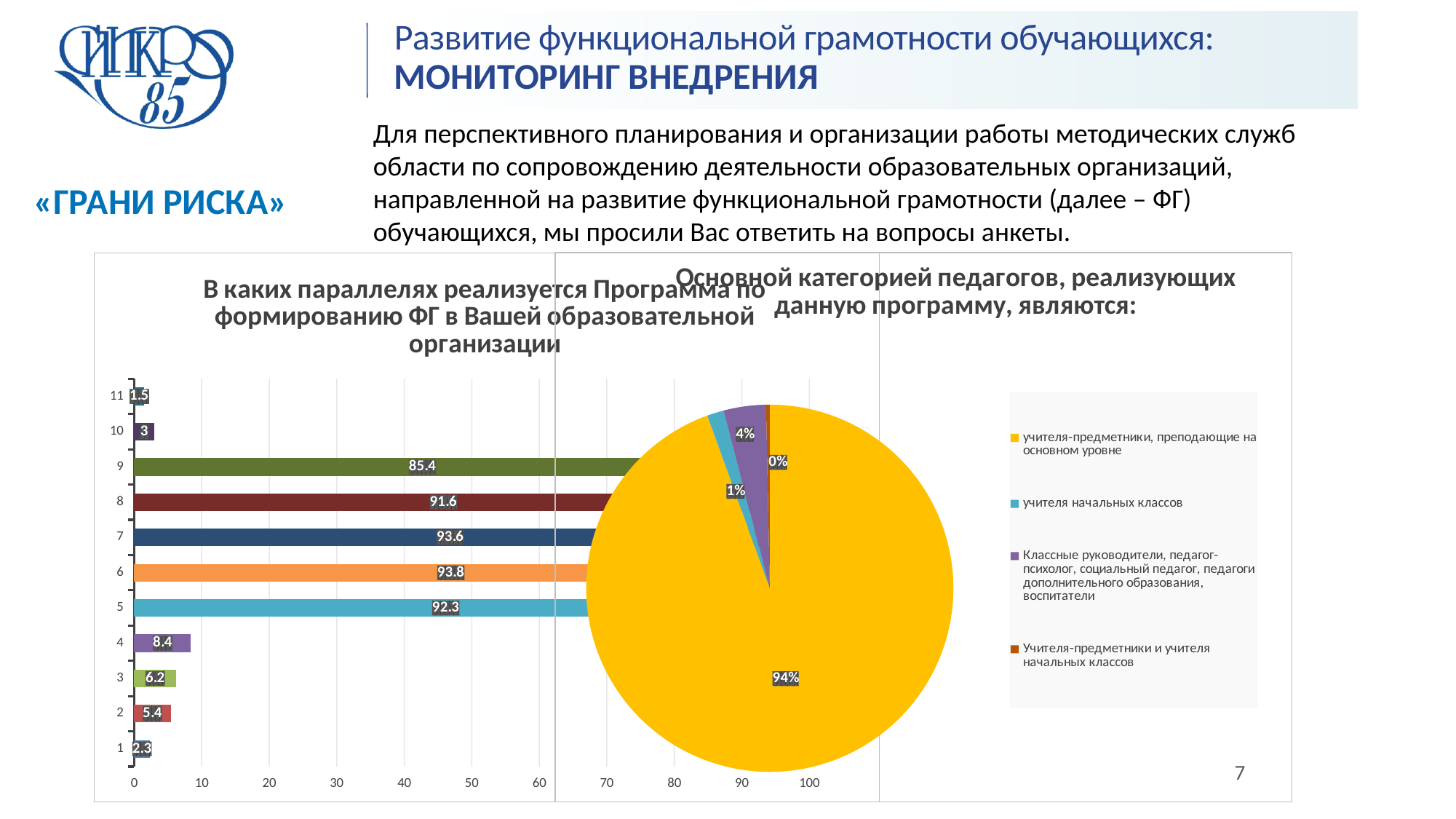
In the bar chart on the left, which has a larger value: parallel 5 or parallel 3? parallel 5 In the bar chart on the left, which parallel has the lowest value? 11 In the bar chart on the left, what is the value for parallel 4? 8.4 In the bar chart on the left, which parallel has the highest value? 6 In the bar chart on the left, what is the value for parallel 9? 85.4 How many parallels (categories) are shown in the bar chart on the left? 11 In the pie chart on the right, what share is shown for учителя-предметники, преподающие на основном уровне? 94% In the bar chart on the left, is the value for parallel 7 greater or less than 90? greater What type of chart is the chart on the left of the slide? bar chart How many entries does the legend of the pie chart on the right list? 4 In the pie chart on the right, what share is shown for учителя начальных классов? 1% In the bar chart on the left, what is the difference between the values for parallel 8 and parallel 2? 86.2